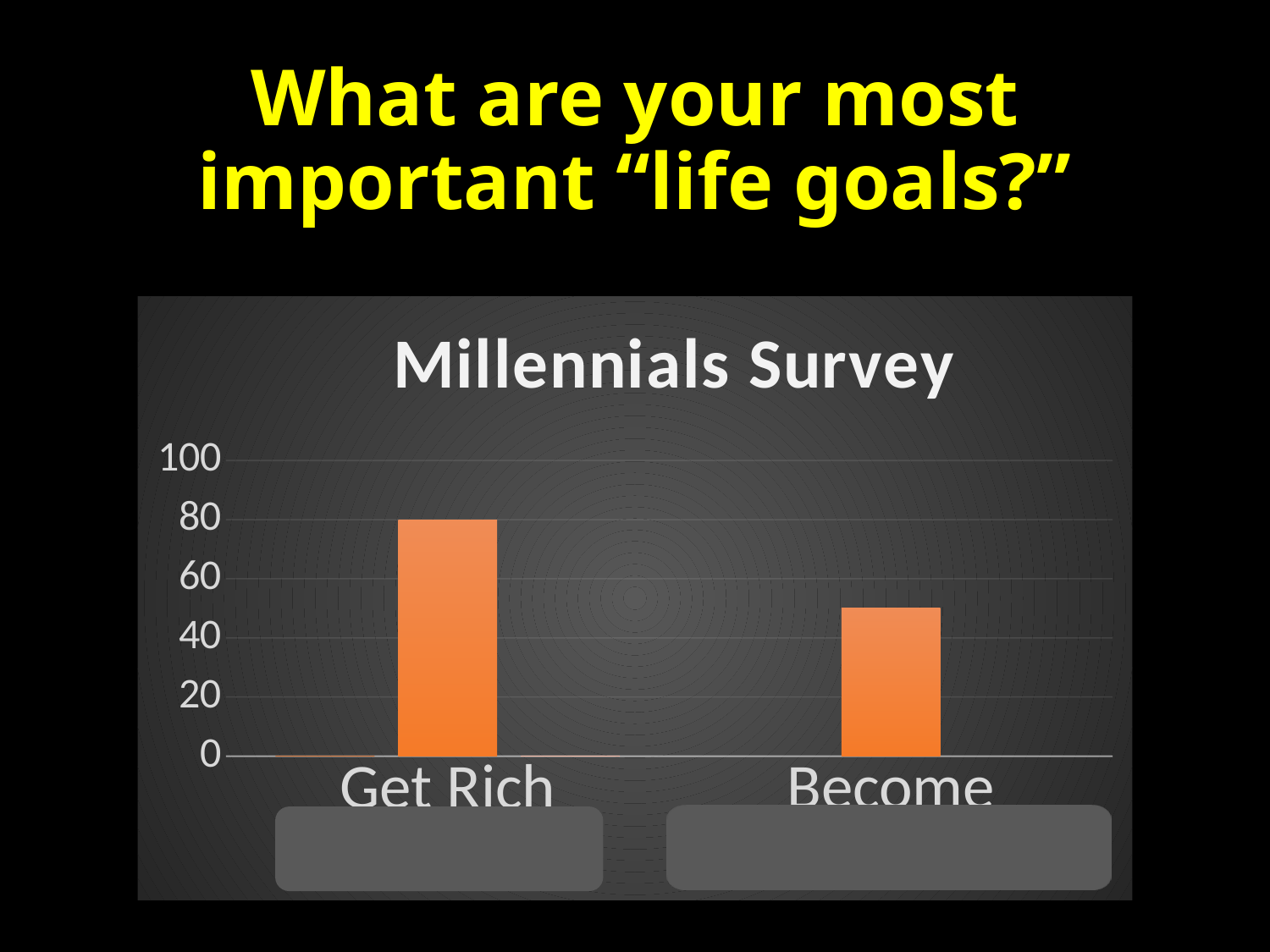
What is the title of the chart? Millennials Survey Which category has the highest bar? Get Rich Do the bar values rise or fall from left to right across the chart? fall Is the value for Become greater or less than 40? greater Which is larger, the bar for Get Rich or the bar for Become? Get Rich Is the value for Get Rich greater or less than 60? greater What value does the bar for Get Rich reach on the axis? 80 Which category has the lowest bar? Become How many bars are plotted in the chart? 2 What kind of chart is shown on the slide? bar chart Is the value for Become greater or less than 60? less What colour are the bars in the chart? orange